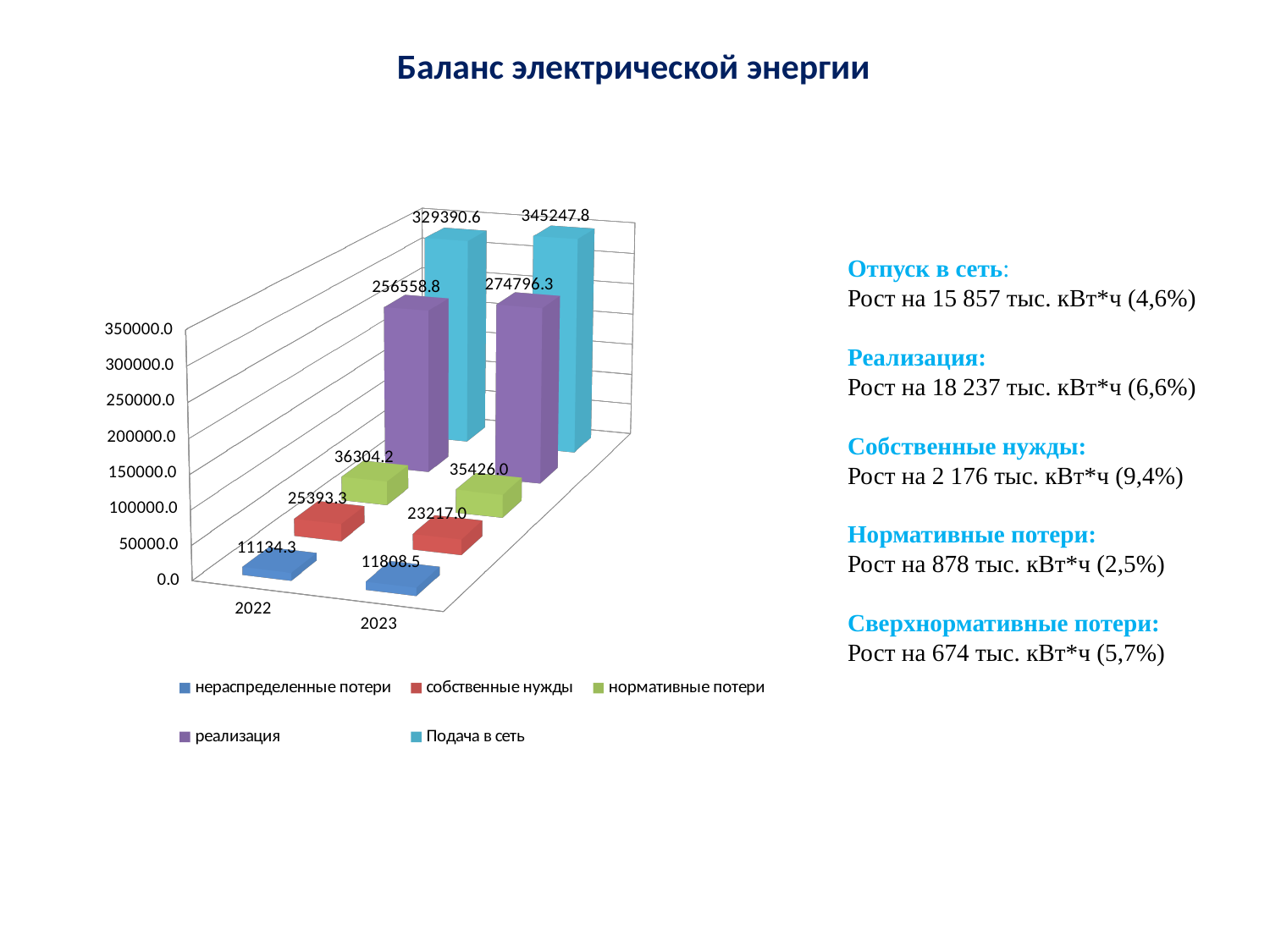
What is the difference between реализация in 2023 and in 2022? 18237.5 What is the value for нормативные потери in 2023? 35426.0 By how much did Подача в сеть increase from 2022 to 2023? 15857.2 What is the value for собственные нужды in 2022? 25393.3 Which series has the lowest value in 2022? нераспределенные потери Which series has the highest value in 2023? Подача в сеть How many series does the legend list? 5 Which is larger: реализация in 2022 or реализация in 2023? реализация in 2023 What is the value for реализация in 2022? 256558.8 What is the value for Подача в сеть in 2023? 345247.8 What is the value for нераспределенные потери in 2022? 11134.3 What type of chart is shown on the slide? bar chart